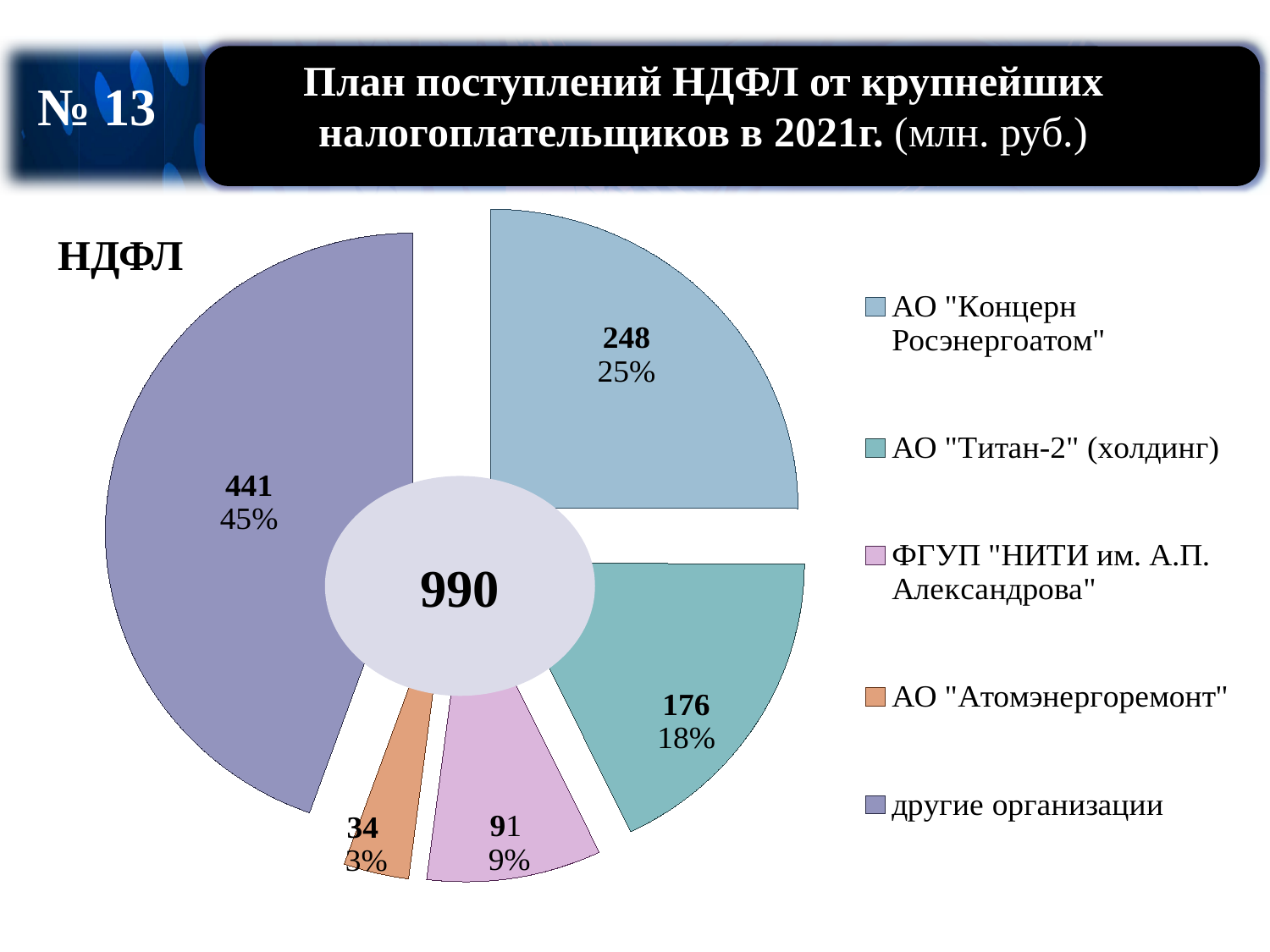
What share of the pie does другие организации account for? 45% Which is larger, the value for ФГУП "НИТИ им. А.П. Александрова" or the value for АО "Атомэнергоремонт"? ФГУП "НИТИ им. А.П. Александрова" Which category has the largest slice of the pie? другие организации What is the difference between the values for АО "Концерн Росэнергоатом" and АО "Титан-2" (холдинг)? 72 What is the value for АО "Концерн Росэнергоатом"? 248 What share of the pie does АО "Титан-2" (холдинг) account for? 18% What is the value for ФГУП "НИТИ им. А.П. Александрова"? 91 What kind of chart is shown on the slide? pie chart How many categories does the legend list? 5 Which category has the smallest slice of the pie? АО "Атомэнергоремонт" What is the value for АО "Атомэнергоремонт"? 34 What is the value for АО "Титан-2" (холдинг)? 176